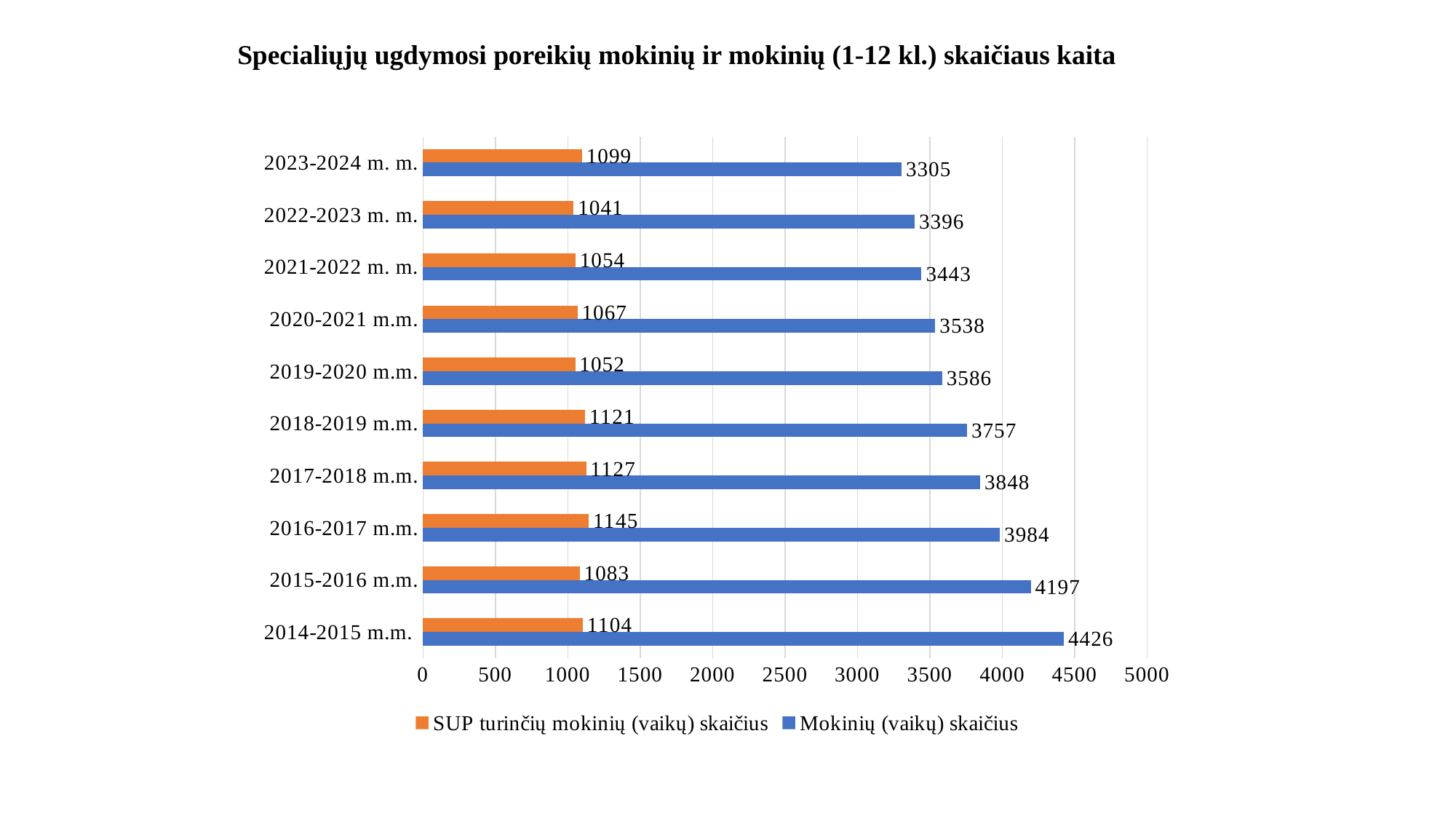
How many series does the legend list? 2 How many school years are shown on the chart? 10 Which school year has the highest 'SUP turinčių mokinių (vaikų) skaičius'? 2016-2017 m.m. What is the difference between 'Mokinių (vaikų) skaičius' in 2014-2015 m.m. and 2023-2024 m. m.? 1121 Is 'Mokinių (vaikų) skaičius' larger in 2019-2020 m.m. or in 2020-2021 m.m.? 2019-2020 m.m. What is the value of 'SUP turinčių mokinių (vaikų) skaičius' for 2023-2024 m. m.? 1099 Which colour represents 'Mokinių (vaikų) skaičius' in the chart? blue Which school year has the lowest 'SUP turinčių mokinių (vaikų) skaičius'? 2022-2023 m. m. Which school year has the highest 'Mokinių (vaikų) skaičius'? 2014-2015 m.m. What kind of chart is shown on the slide? bar chart What is the value of 'Mokinių (vaikų) skaičius' for 2014-2015 m.m.? 4426 Is the value of 'Mokinių (vaikų) skaičius' for 2017-2018 m.m. greater or less than 4000? less